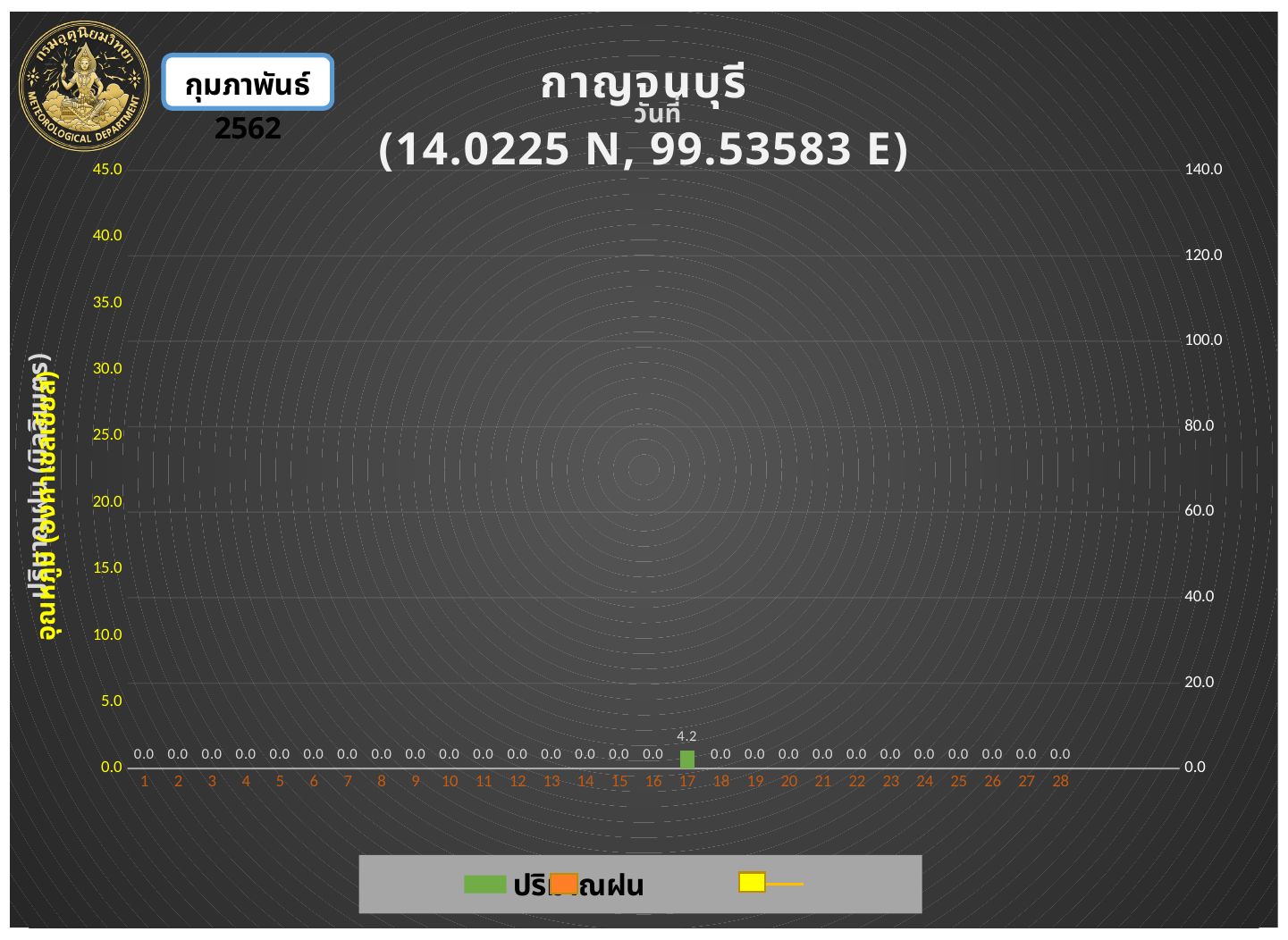
Which is larger, the rainfall value on day 17 or on day 18? day 17 Which day has the highest rainfall value? 17 How many days are shown on the x axis? 28 What is the maximum value shown on the right y axis? 140.0 Is the rainfall value for day 17 greater or less than 5.0 on the left axis? less What is the rainfall value shown for day 28? 0.0 What is the rainfall value shown for day 5? 0.0 What kind of chart is used to show the rainfall values? bar chart What are the coordinates given in the chart title? 14.0225 N, 99.53583 E What is the rainfall value shown for day 17? 4.2 What is the difference between the rainfall value on day 17 and on day 16? 4.2 What is the maximum value shown on the left y axis? 45.0